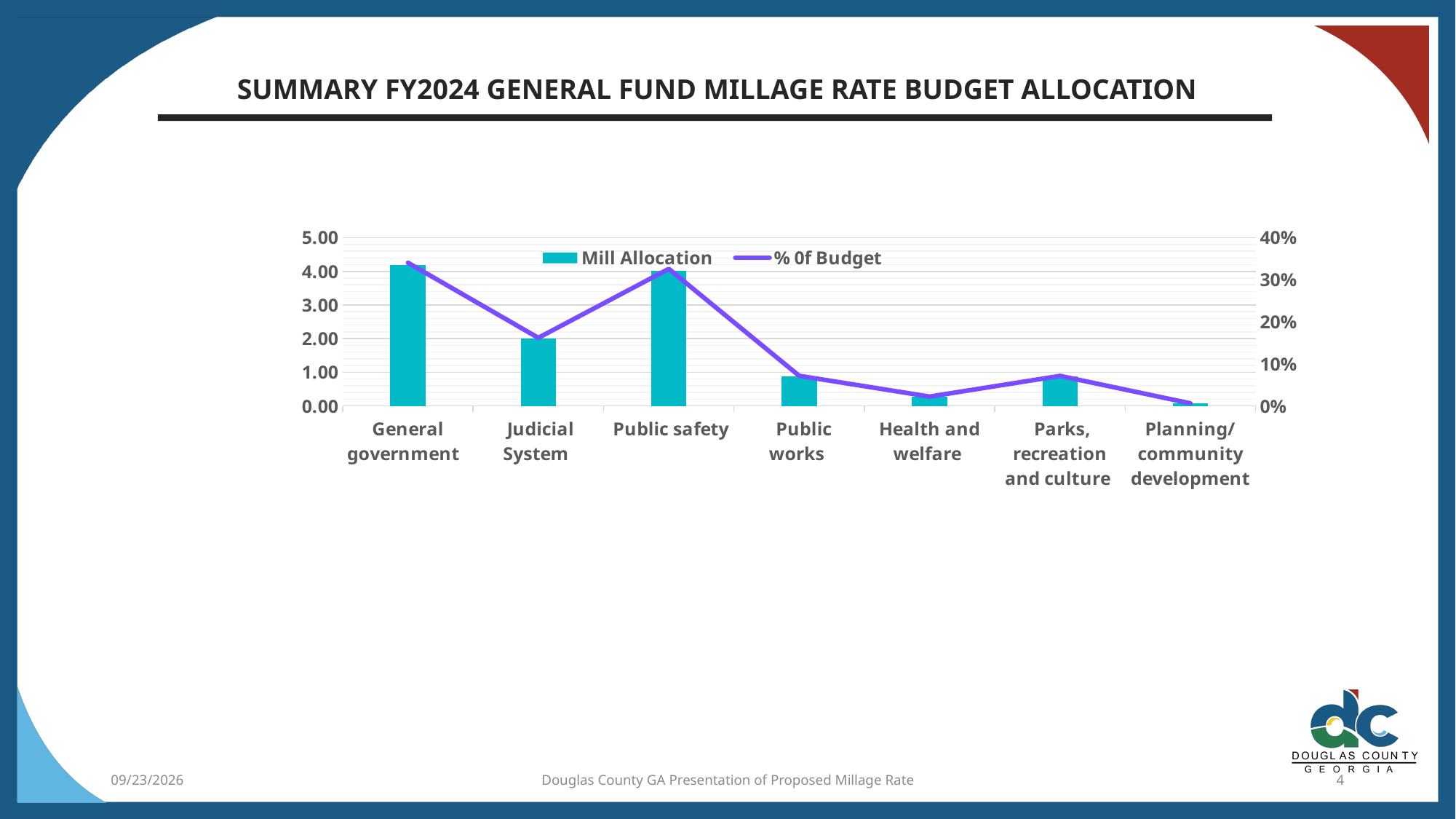
How many categories are shown on the x axis of the chart? 7 Is the Mill Allocation value for Public safety greater or less than 3.00? greater What kind of chart is shown on the slide? bar chart with a line Is the Mill Allocation value for General government greater or less than 4.00? greater Is the Mill Allocation value for Health and welfare greater or less than 1.00? less Which has the larger % of Budget, Public safety or Parks, recreation and culture? Public safety Which has the larger Mill Allocation, Judicial System or Public works? Judicial System What are the two series named in the chart's legend? Mill Allocation and % 0f Budget How many series does the chart's legend list? 2 Which category has the lowest Mill Allocation bar? Planning/community development Which category has the highest Mill Allocation bar? General government